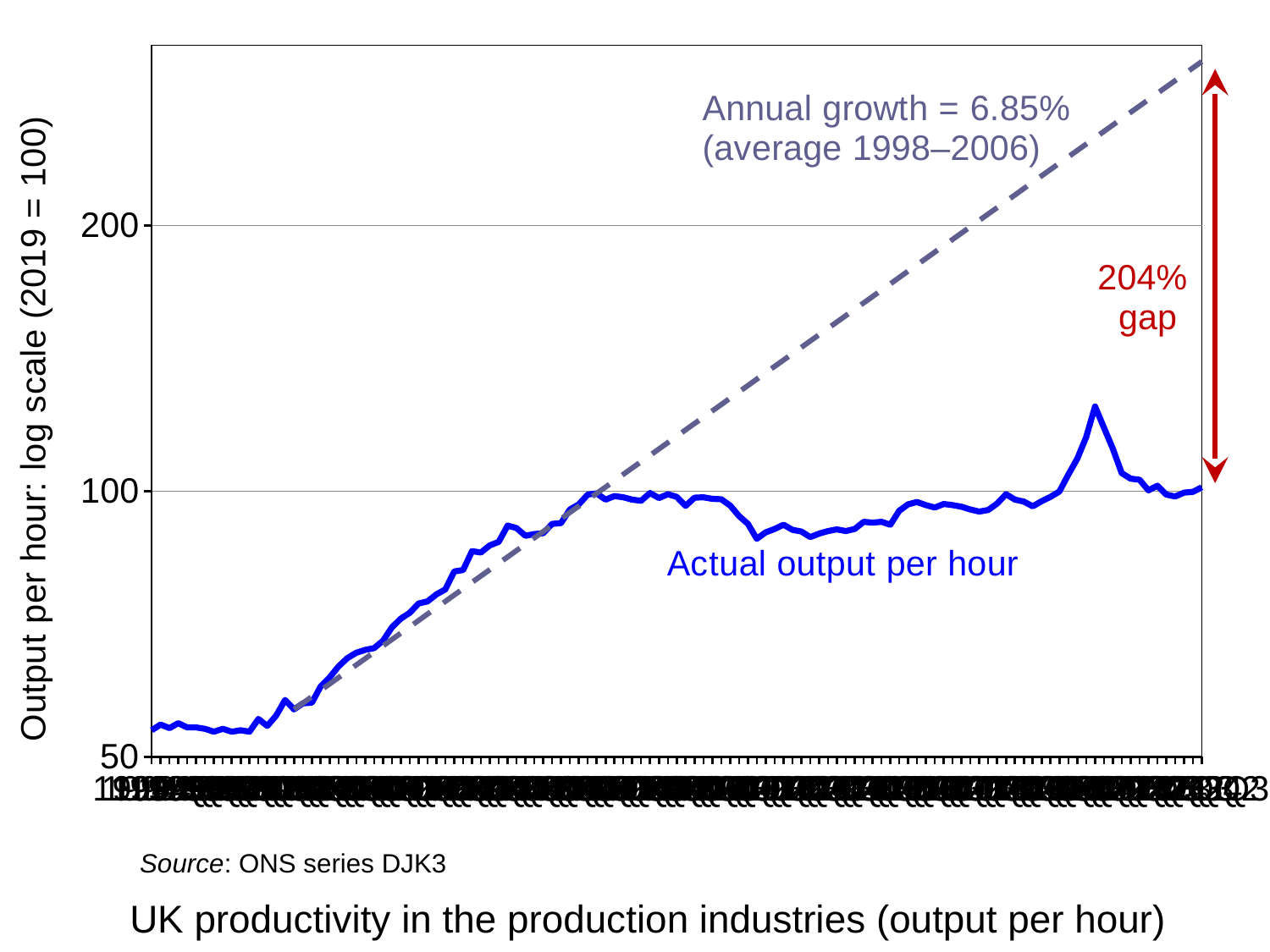
Is the value of the dashed trend line at the right-hand end of the chart greater or less than 200? greater What kind of chart is shown on the slide? line chart Is the peak value of actual output per hour near the end of the series greater or less than 200? less What annual growth rate is stated for the dashed trend line? 6.85% What source is cited for the chart data? ONS series DJK3 What is the size of the gap between the trend line and actual output per hour at the end of the series, as labelled on the chart? 204% What is the title of the chart? UK productivity in the production industries (output per hour) Does actual output per hour rise or fall over the first half of the series? rise What is the label of the solid blue line? Actual output per hour Over which period is the 6.85% annual growth rate averaged? 1998–2006 What is the y-axis label of the chart? Output per hour: log scale (2019 = 100) Is the value of actual output per hour at the start of the series greater or less than 100? less